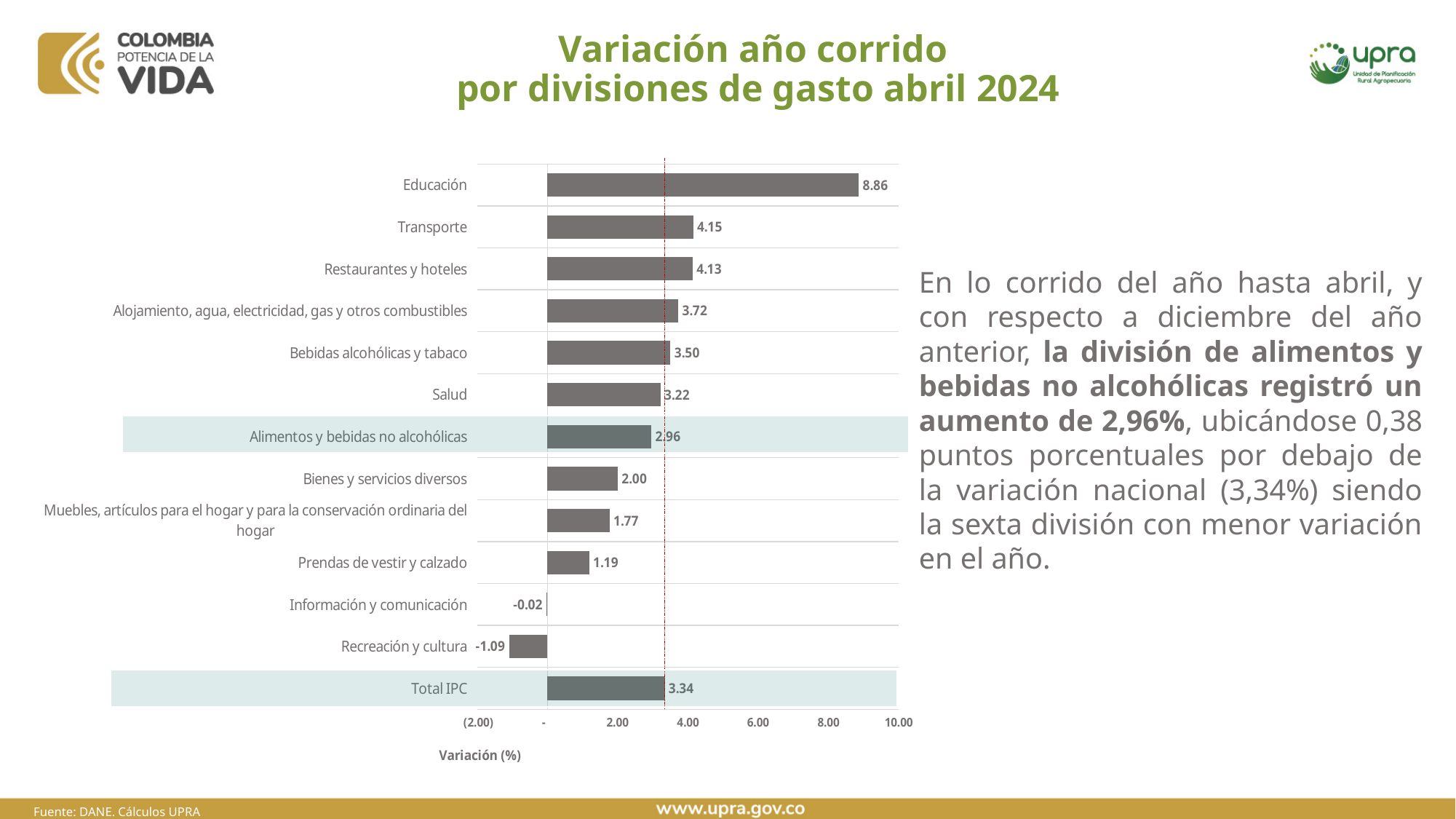
What is the value for Educación? 8.86 Which category has the highest value? Educación What is the title of the horizontal axis? Variación (%) How many bars are plotted in the chart? 13 What kind of chart is shown on the slide? bar chart What is the value for Recreación y cultura? -1.09 What is the difference between the values for Educación and Transporte? 4.71 What is the value for Total IPC? 3.34 Which is larger, the value for Salud or the value for Bienes y servicios diversos? Salud What is the difference between the values for Total IPC and Alimentos y bebidas no alcohólicas? 0.38 What is the value for Alimentos y bebidas no alcohólicas? 2.96 Which category has the lowest value? Recreación y cultura